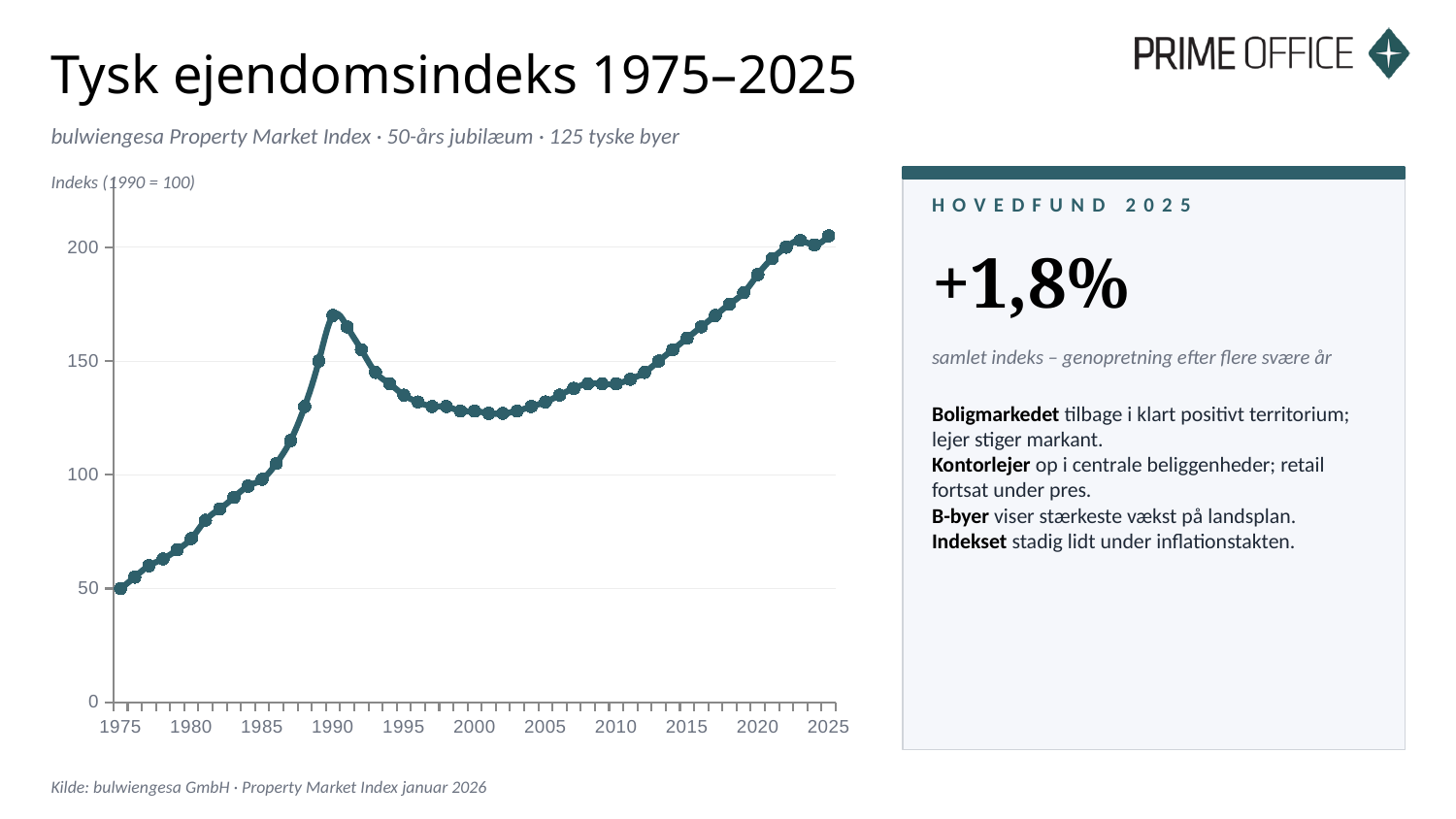
Which year has the highest index value on the chart, 1990 or 2025? 2025 According to the axis label, which year is the index base year (= 100)? 1990 Is the index value for 2010 greater or less than 150? less Does the index rise or fall between 1990 and 2000? fall Does the index rise or fall between 1975 and 1990? rise What is the title of the chart on the slide? Tysk ejendomsindeks 1975–2025 Is the index value for 2025 greater or less than 200? greater What kind of chart is shown on the slide? line chart Is the index value for 2000 greater or less than 150? less Which year has the lowest index value on the chart? 1975